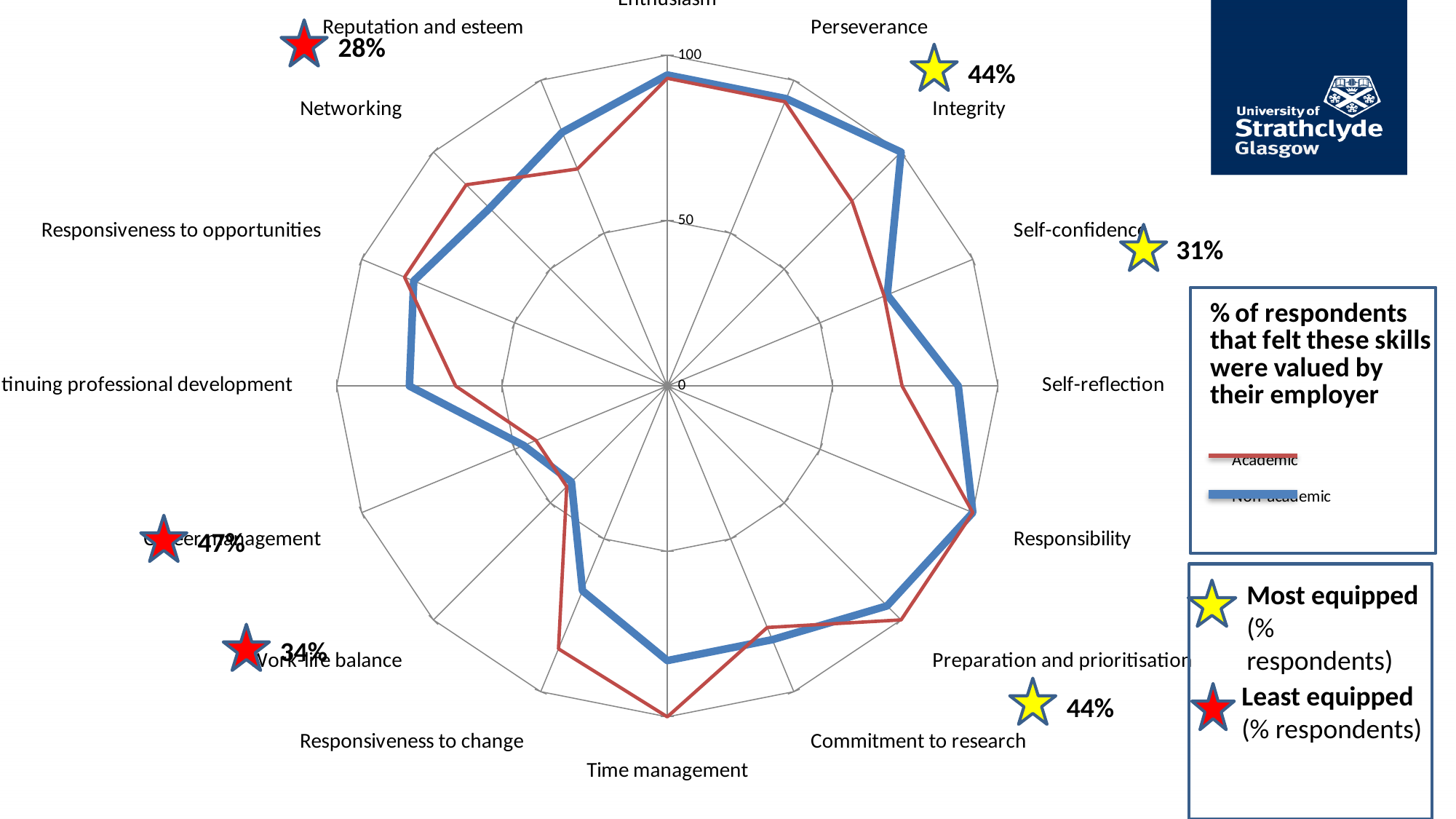
For Responsiveness to change, which series has the larger value, Academic or Non-academic? Academic How many series does the chart's legend list? 2 What does the text box beside the chart say the chart shows? % of respondents that felt these skills were valued by their employer For Time management, which series has the larger value, Academic or Non-academic? Academic Which series is drawn in blue on the radar chart? Non-academic Is the Non-academic value for Self-reflection greater or less than 50? greater How many skill categories are plotted around the radar chart? 16 For Integrity, which series has the larger value, Academic or Non-academic? Non-academic Is the Academic value for Time management greater or less than 50? greater What kind of chart is shown on the slide? Radar chart